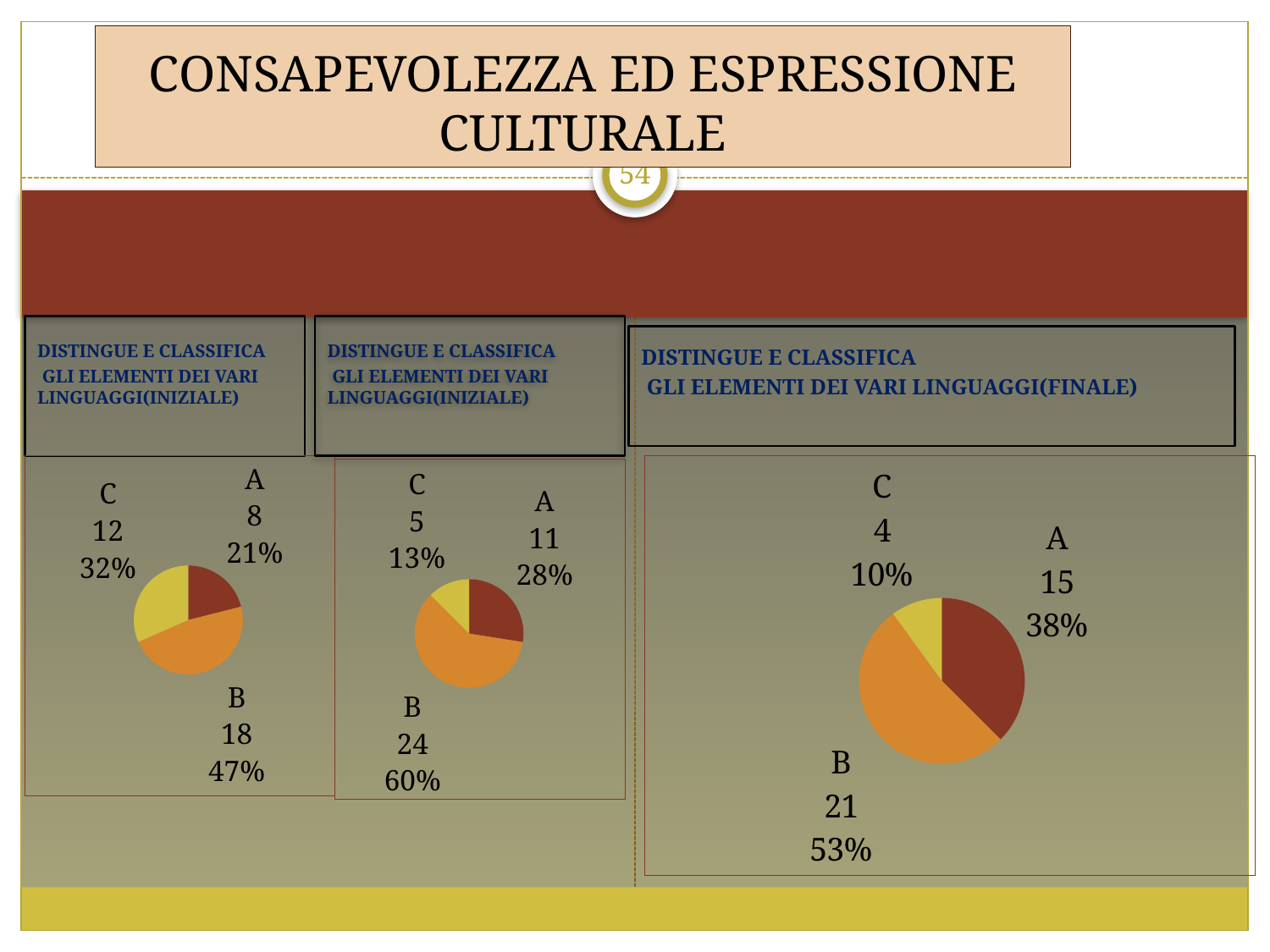
In the middle pie chart, which category has the largest value? B In the middle pie chart, what value is shown for category A? 11 In the middle pie chart, what percentage share does category B have? 60% In the rightmost pie chart (FINALE), which is larger, the value for A or the value for B? B In the rightmost pie chart (FINALE), what percentage share does category A have? 38% In the rightmost pie chart (FINALE), what value is shown for category C? 4 In the leftmost pie chart, what value is shown for category B? 18 How many categories does the rightmost pie chart (FINALE) show? 3 What type of chart is used in the rightmost chart (FINALE)? Pie chart In the leftmost pie chart, what percentage share does category C have? 32% In the middle pie chart, what is the difference between the values for B and C? 19 In the leftmost pie chart, which category has the smallest value? A